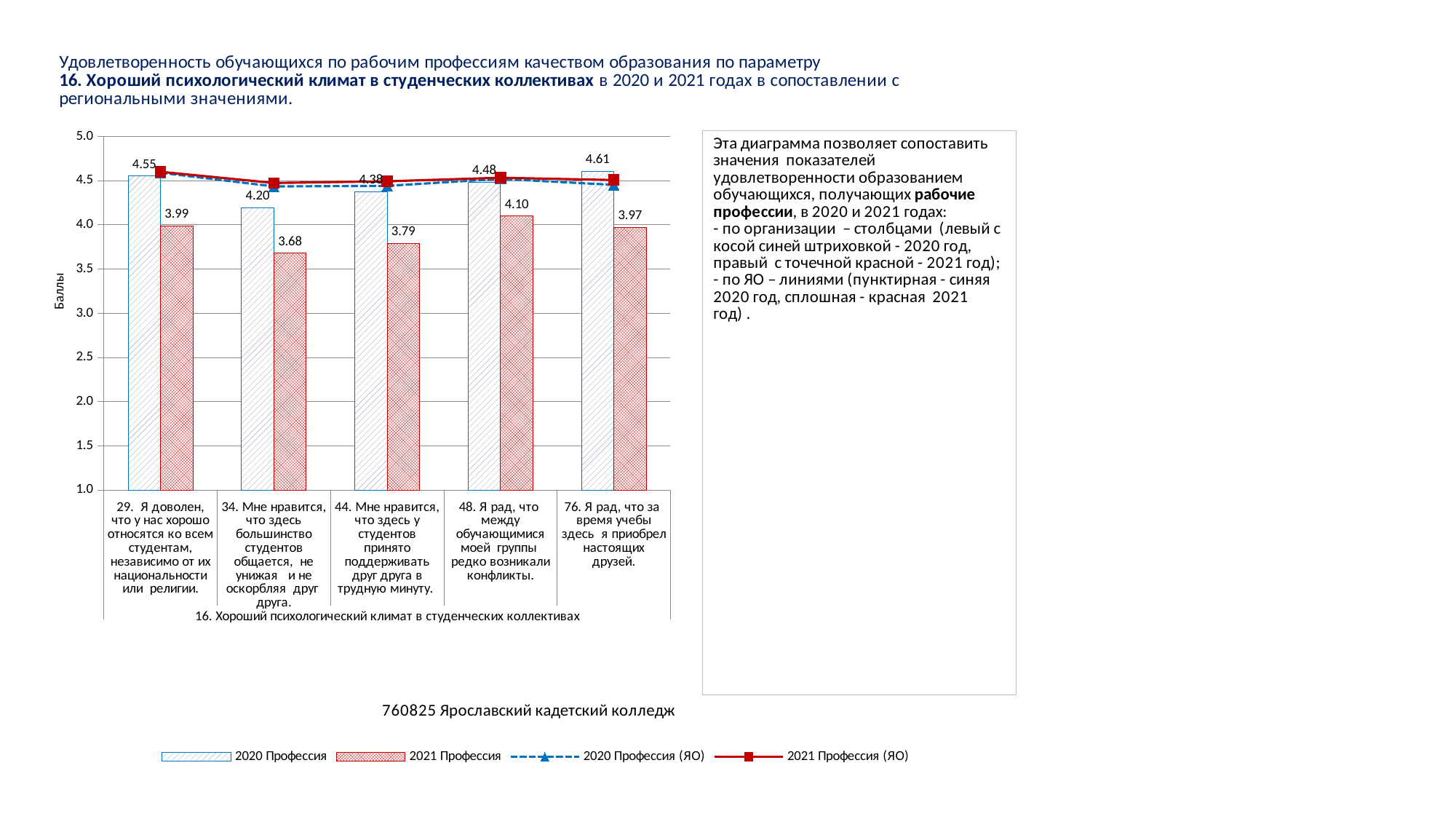
What is the difference between the 2020 Профессия and 2021 Профессия values for item 76? 0.64 What is the value of the 2020 Профессия bar for item 29 (Я доволен, что у нас хорошо относятся ко всем студентам...)? 4.55 How many series does the legend list? 4 Which item has the lowest 2021 Профессия bar? 34. Мне нравится, что здесь большинство студентов общается, не унижая и не оскорбляя друг друга. Is the 2021 Профессия (ЯО) line value for item 29 greater or less than 4.5? greater Which item has the highest 2020 Профессия bar? 76. Я рад, что за время учебы здесь я приобрел настоящих друзей. What is the value of the 2021 Профессия bar for item 48 (Я рад, что между обучающимися моей группы редко возникали конфликты)? 4.10 What is the label of the vertical axis? Баллы What is the value of the 2021 Профессия bar for item 34 (Мне нравится, что здесь большинство студентов общается...)? 3.68 How many survey items (categories) are shown on the x axis? 5 What kind of chart is shown on the slide? Combined bar and line chart For item 44, which is larger: the 2020 Профессия bar or the 2021 Профессия bar? 2020 Профессия